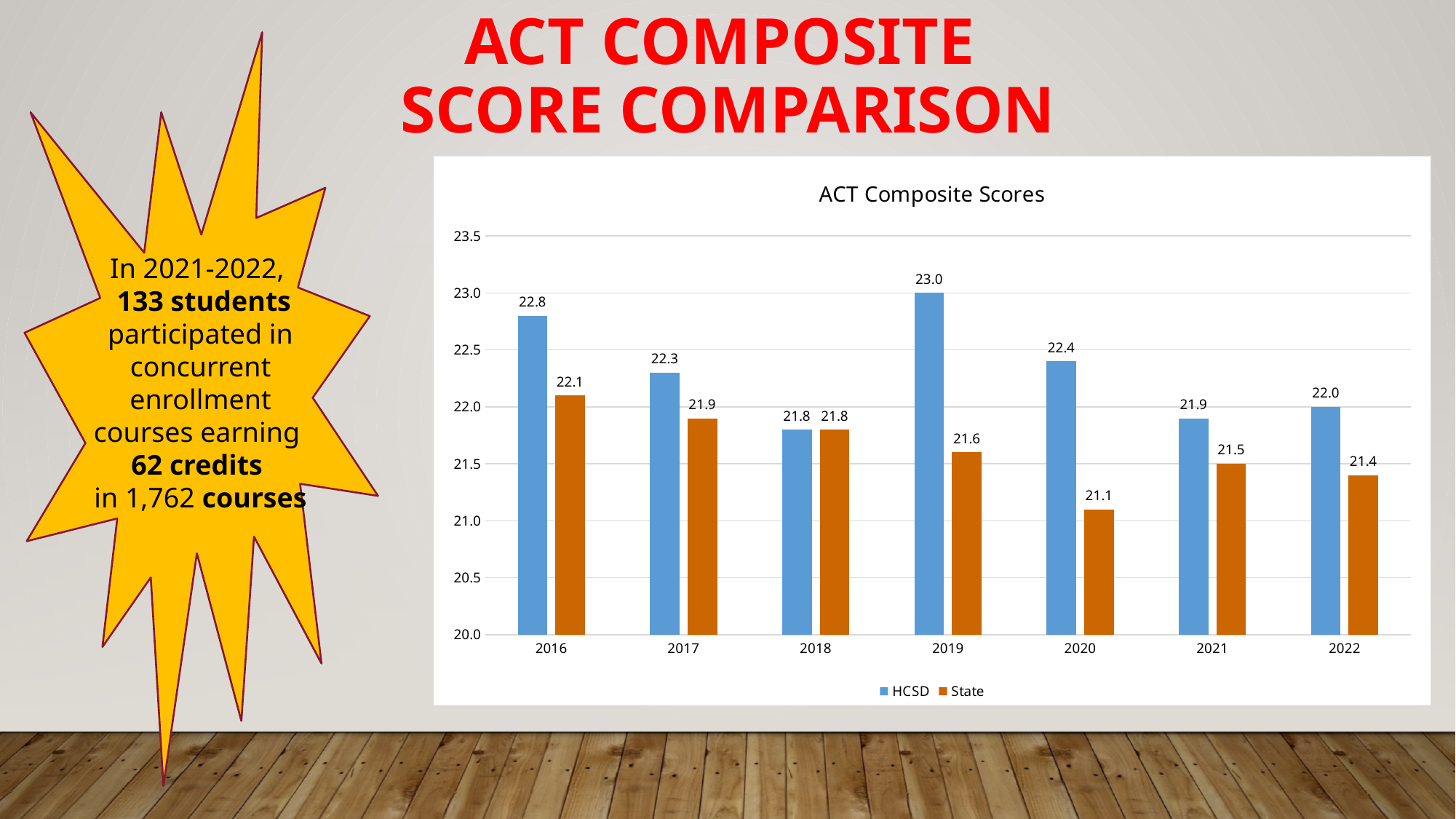
What is the difference between the HCSD score in 2016 and the HCSD score in 2022? 0.8 Which is larger in 2020, the HCSD score or the State score? HCSD What is the HCSD ACT composite score for 2022? 22.0 In which year is the State ACT composite score lowest? 2020 What is the HCSD ACT composite score for 2019? 23.0 How many series does the chart legend list? 2 What type of chart is used to show the ACT composite scores? Bar chart What is the difference between the HCSD and State scores in 2019? 1.4 What is the title of the chart? ACT Composite Scores In which year is the HCSD ACT composite score highest? 2019 What is the State ACT composite score for 2020? 21.1 How many years are shown on the x axis of the chart? 7